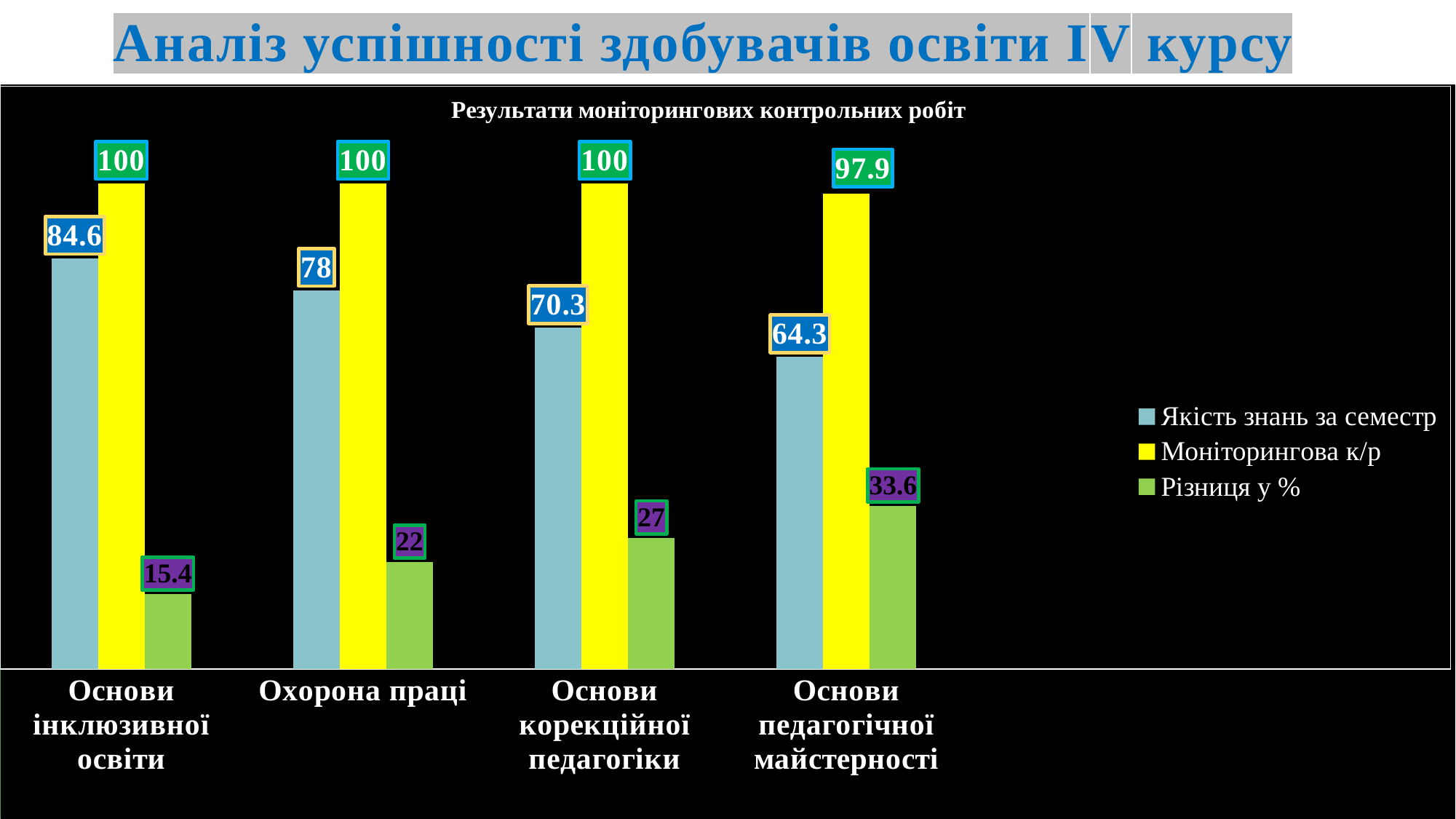
Do the values for "Різниця у %" rise or fall from left to right across the categories? Rise What is the value of "Якість знань за семестр" for "Основи інклюзивної освіти"? 84.6 Which category has the highest value for "Різниця у %"? Основи педагогічної майстерності Which is larger: "Якість знань за семестр" for "Охорона праці" or for "Основи корекційної педагогіки"? Охорона праці What is the value of "Різниця у %" for "Охорона праці"? 22 What is the value of "Моніторингова к/р" for "Основи педагогічної майстерності"? 97.9 What kind of chart is shown on the slide? Bar chart How many series does the legend list? 3 How many categories are shown on the x axis? 4 What is the difference between "Моніторингова к/р" and "Якість знань за семестр" for "Основи корекційної педагогіки"? 29.7 What is the title of the chart? Результати моніторингових контрольних робіт Which category has the lowest value for "Якість знань за семестр"? Основи педагогічної майстерності